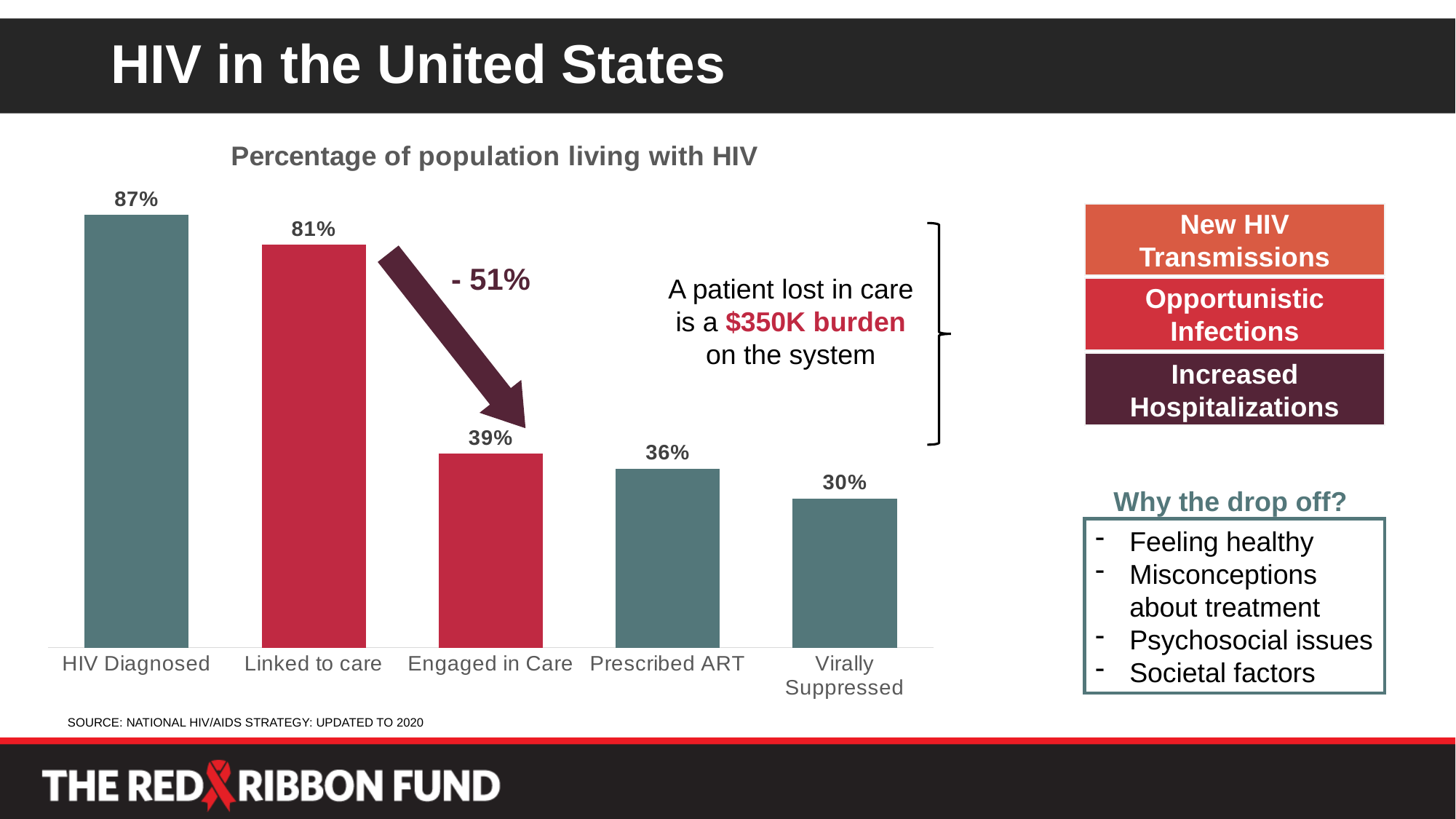
What is the value for Prescribed ART? 36% What is the value for Linked to care? 81% How many categories are shown in the chart? 5 What is the difference between the values for Linked to care and Engaged in Care? 42% What is the value for Virally Suppressed? 30% Which is larger, the value for Prescribed ART or the value for Virally Suppressed? Prescribed ART Which category has the highest value? HIV Diagnosed What is the value for Engaged in Care? 39% What is the title of the chart? Percentage of population living with HIV What kind of chart is shown on the slide? Bar chart Which category has the lowest value? Virally Suppressed What is the value for HIV Diagnosed? 87%